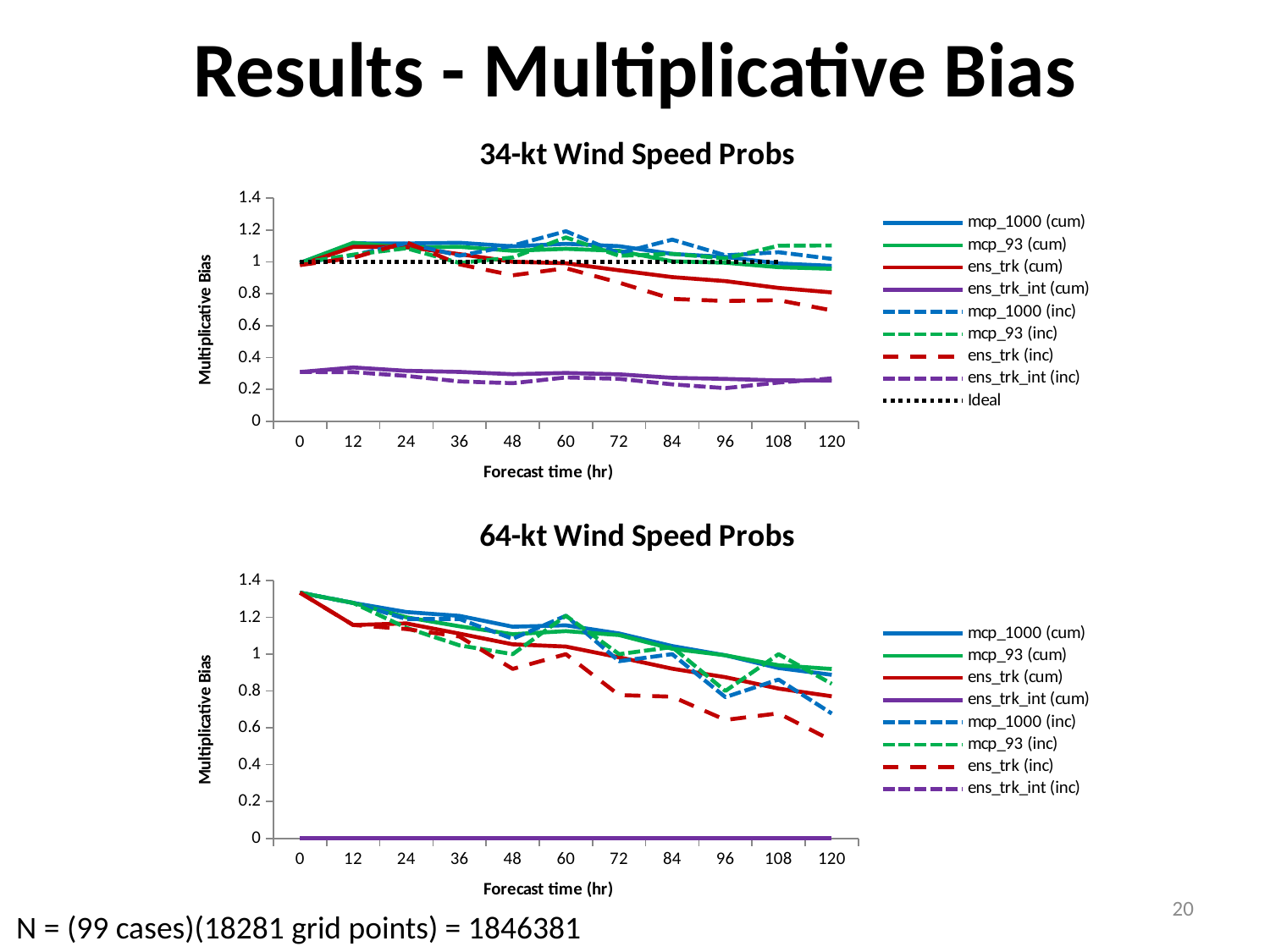
What is the label of the y axis on the 64-kt Wind Speed Probs chart? Multiplicative Bias In the 34-kt Wind Speed Probs chart, at what multiplicative bias value does the Ideal line sit? 1 In the 34-kt Wind Speed Probs chart, which is larger at forecast time 120: mcp_1000 (cum) or ens_trk_int (cum)? mcp_1000 (cum) How many series does the legend of the 34-kt Wind Speed Probs chart list? 9 How many series does the legend of the 64-kt Wind Speed Probs chart list? 8 What type of chart is the 34-kt Wind Speed Probs chart? line chart In the 64-kt Wind Speed Probs chart, is the value for mcp_1000 (cum) at forecast time 0 greater or less than 1.2? greater In the 64-kt Wind Speed Probs chart, is the value for ens_trk (inc) at forecast time 120 greater or less than 0.6? less In the 64-kt Wind Speed Probs chart, does the ens_trk (cum) series rise or fall as forecast time increases? fall How many forecast time points are marked on the x axis of the 64-kt Wind Speed Probs chart? 11 In the 34-kt Wind Speed Probs chart, is the value for ens_trk (inc) at forecast time 120 greater or less than 0.8? less